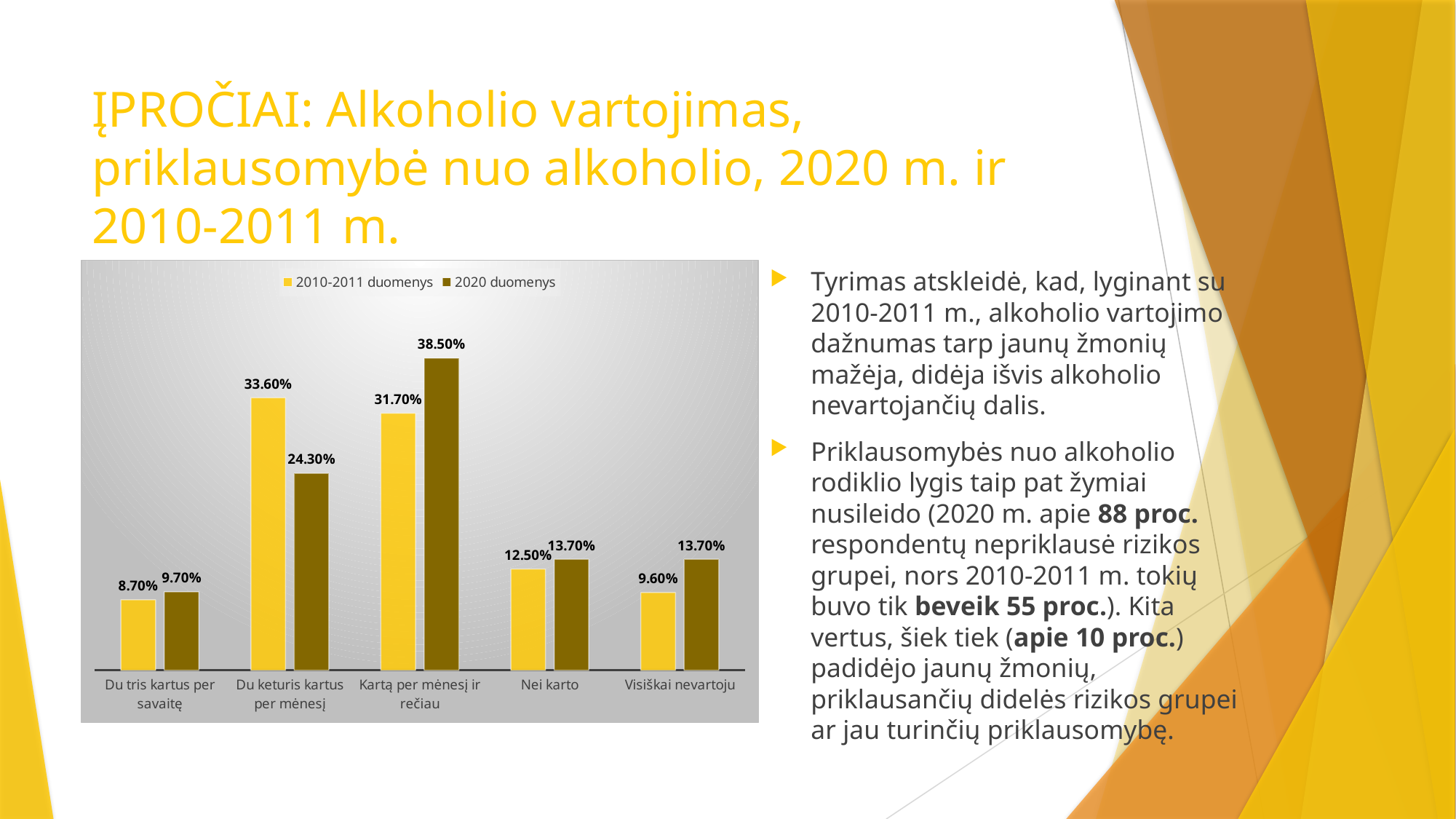
Which colour represents the 2020 duomenys series in the chart? Dark brown What is the difference between the 2010-2011 duomenys and 2020 duomenys values for "Du keturis kartus per mėnesį"? 9.30% What is the value for "Nei karto" in the 2010-2011 duomenys series? 12.50% What is the value for "Du keturis kartus per mėnesį" in the 2010-2011 duomenys series? 33.60% What is the value for "Kartą per mėnesį ir rečiau" in the 2020 duomenys series? 38.50% Which category has the lowest value in the 2010-2011 duomenys series? Du tris kartus per savaitę Which category has the highest value in the 2020 duomenys series? Kartą per mėnesį ir rečiau What is the value for "Visiškai nevartoju" in the 2020 duomenys series? 13.70% What kind of chart is shown on the slide? Bar chart How many categories are shown on the x axis of the chart? 5 How many series does the chart legend list? 2 For "Kartą per mėnesį ir rečiau", which series has the larger value, 2010-2011 duomenys or 2020 duomenys? 2020 duomenys